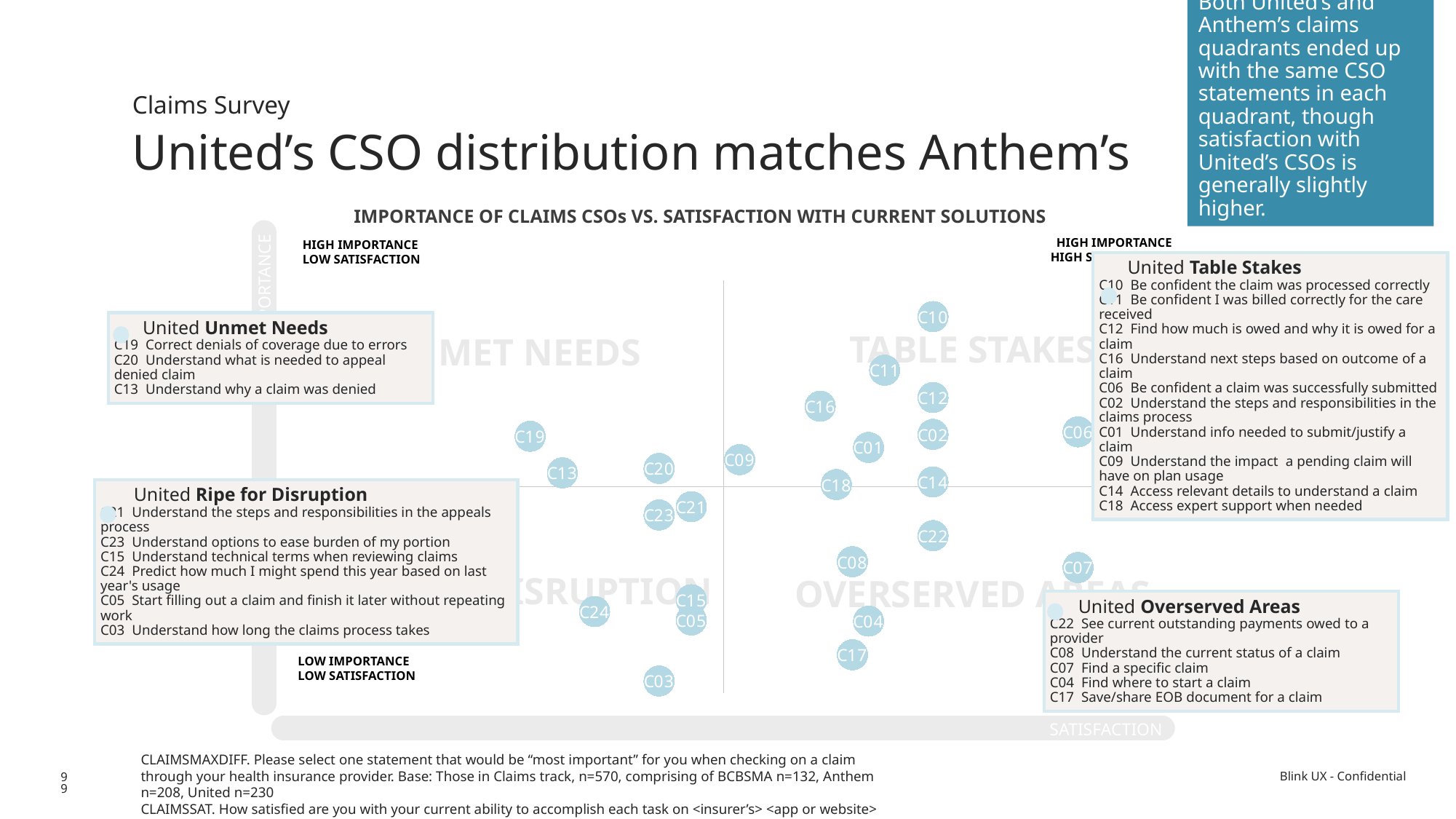
What is the title of the chart? IMPORTANCE OF CLAIMS CSOs VS. SATISFACTION WITH CURRENT SOLUTIONS In which quadrant of the chart does point C10 fall? Table Stakes What does the horizontal axis of the chart represent? Satisfaction How many CSO statements are listed in the United Unmet Needs box? 3 Which is plotted further right on the satisfaction axis, C14 or C13? C14 How many CSO points are plotted on the chart? 24 Which CSO point is plotted furthest left on the satisfaction axis? C19 Which CSO point is plotted highest on the importance axis? C10 Which CSO point is plotted lowest on the importance axis? C03 What kind of chart is shown on the slide? Scatter plot In which quadrant of the chart does point C03 fall? Ripe for Disruption Which is plotted higher on the importance axis, C10 or C17? C10